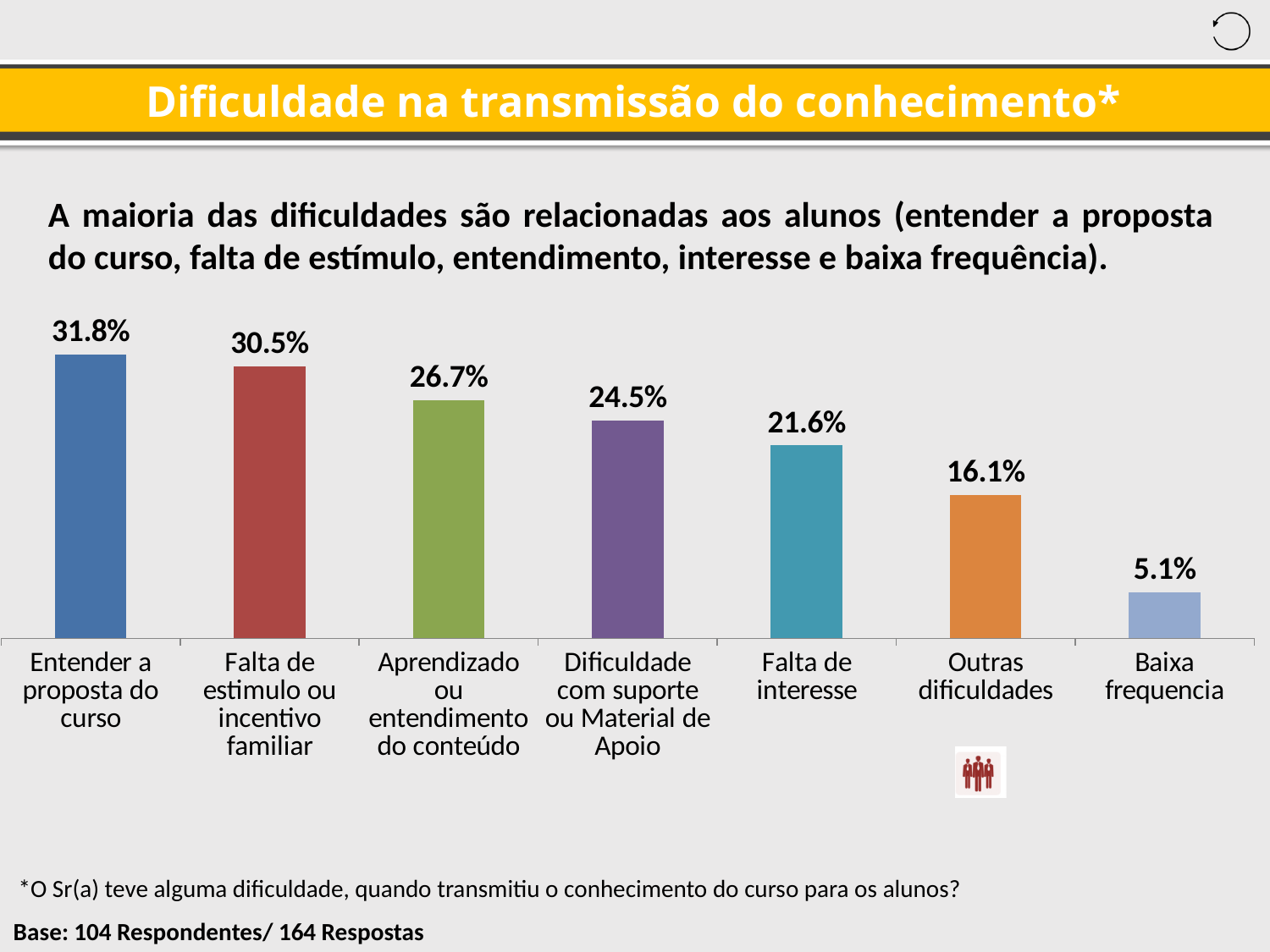
Which is larger: 'Aprendizado ou entendimento do conteúdo' or 'Falta de interesse'? Aprendizado ou entendimento do conteúdo Do the values rise or fall from left to right along the x axis? Fall What is the value for 'Dificuldade com suporte ou Material de Apoio'? 24.5% What is the difference between 'Outras dificuldades' and 'Baixa frequencia'? 11.0% What is the value for 'Baixa frequencia'? 5.1% What kind of chart is shown on the slide? Bar chart How many categories are shown in the chart? 7 What is the value for 'Falta de interesse'? 21.6% What is the difference between 'Entender a proposta do curso' and 'Falta de estimulo ou incentivo familiar'? 1.3% Which category has the highest value? Entender a proposta do curso Which category has the lowest value? Baixa frequencia What is the value for 'Entender a proposta do curso'? 31.8%